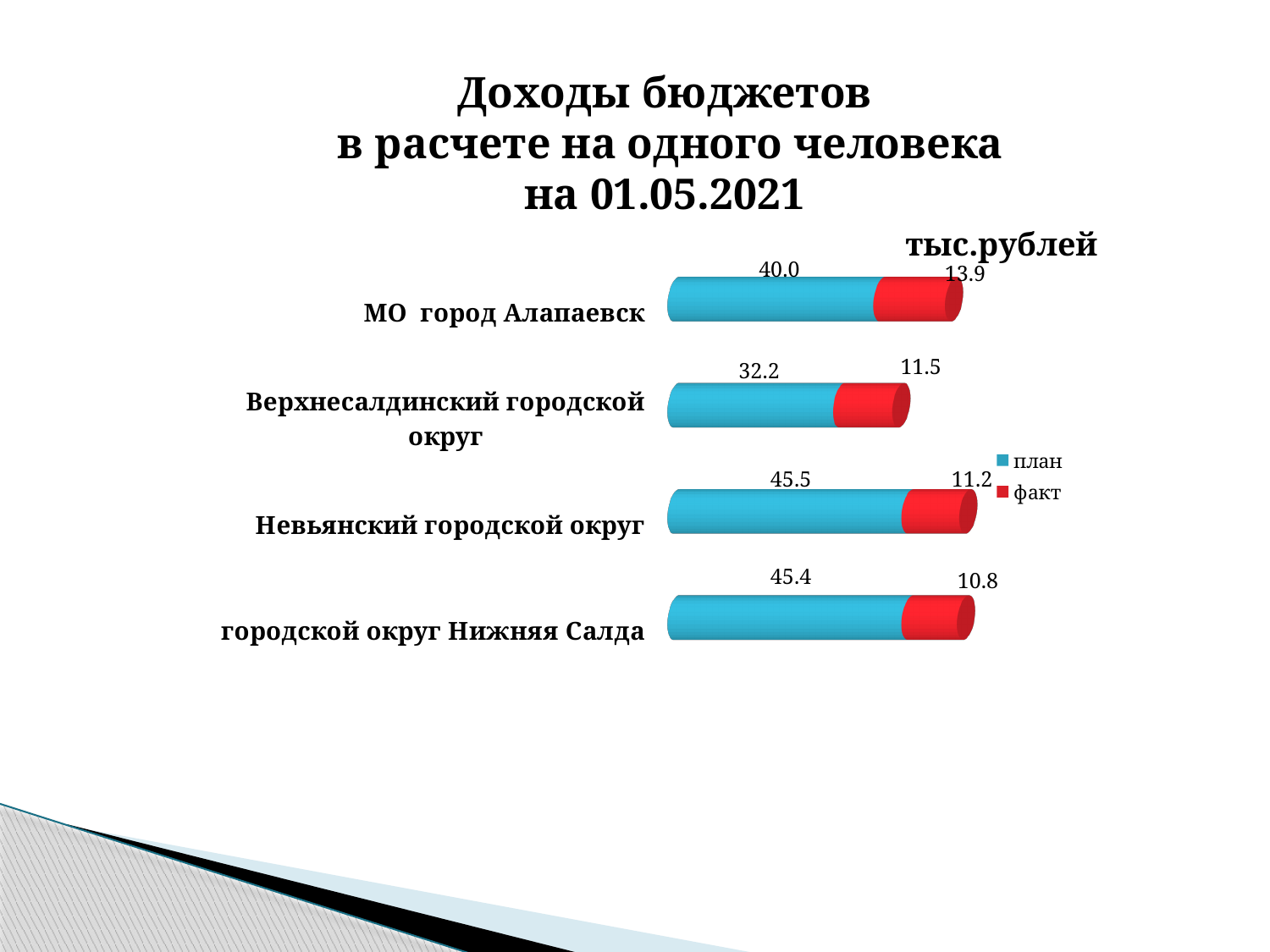
What kind of chart is shown on the slide? Bar chart Which category has the lowest план value? Верхнесалдинский городской округ Which category has the highest факт value? МО город Алапаевск What is the план value for Невьянский городской округ? 45.5 What is the факт value for Верхнесалдинский городской округ? 11.5 What unit is indicated for the chart values? тыс.рублей Which is larger: the факт value for Невьянский городской округ or for городской округ Нижняя Салда? Невьянский городской округ What is the difference between the план and факт values for МО город Алапаевск? 26.1 What is the план value for МО город Алапаевск? 40.0 How many categories are shown in the chart? 4 What is the факт value for городской округ Нижняя Салда? 10.8 How many series does the legend list? 2